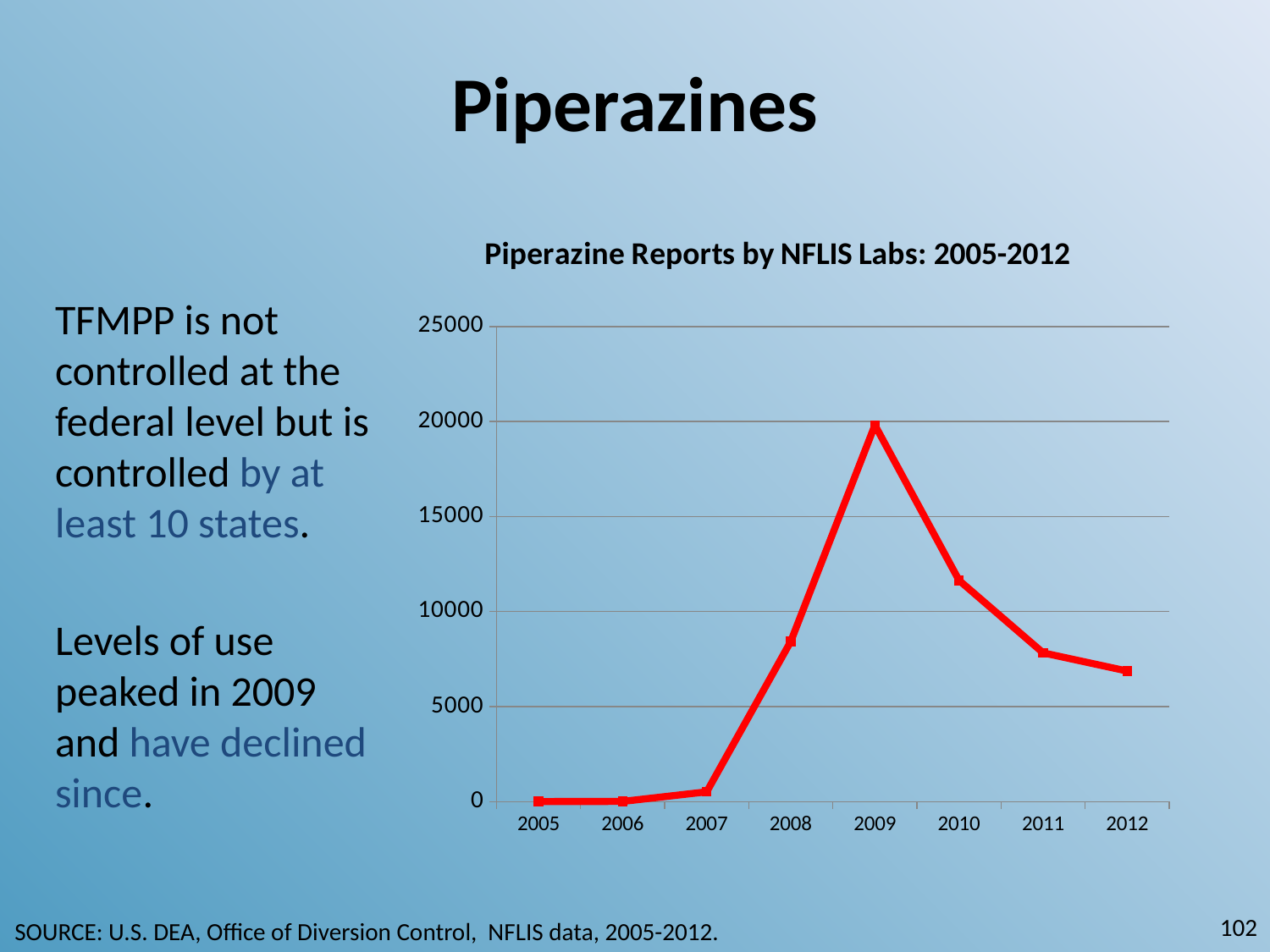
Is the value for 2012 greater or less than 5000? greater What kind of chart is shown on the slide? line chart Is the value for 2007 greater or less than 5000? less Do the values rise or fall from 2009 to 2012? fall Is the value for 2009 greater or less than 15000? greater Which year has the larger value, 2010 or 2011? 2010 Do the values rise or fall from 2006 to 2009? rise Which year has the highest number of piperazine reports? 2009 How many years are plotted on the x axis of the chart? 8 What is the title of the chart? Piperazine Reports by NFLIS Labs: 2005-2012